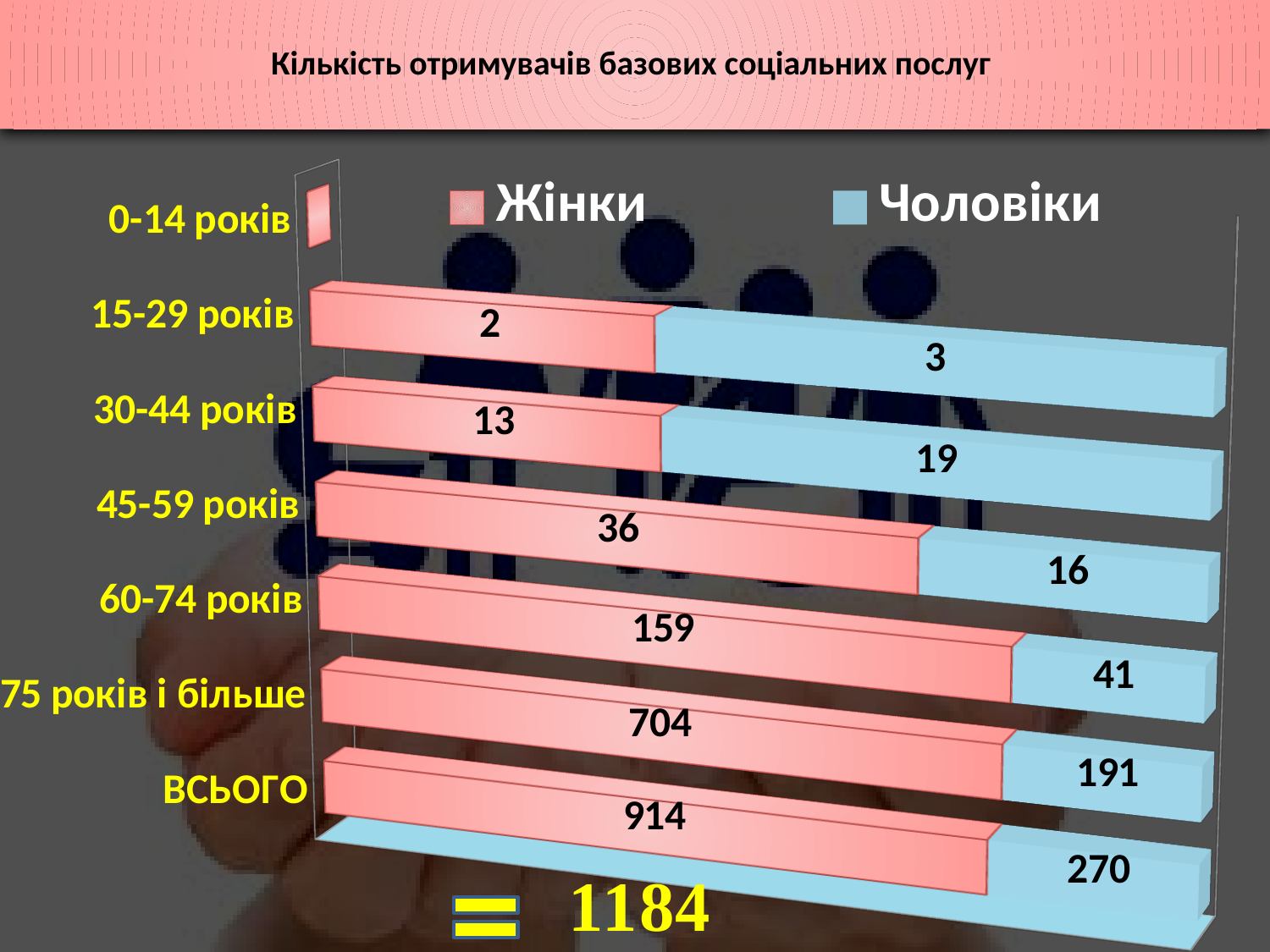
What kind of chart is shown on the slide? stacked bar chart How many series does the legend list? 2 What is the total of the stacked bar for the ВСЬОГО category? 1184 What is the total of the stacked bar for the 60-74 років category? 200 What is the title of the chart? Кількість отримувачів базових соціальних послуг What is the difference between the Жінки and Чоловіки values in the ВСЬОГО category? 644 What is the value for Чоловіки in the 60-74 років category? 41 What is the value for Жінки in the 45-59 років category? 36 Which age category has the highest value for Жінки (excluding ВСЬОГО)? 75 років і більше Which is larger in the 45-59 років category, Жінки or Чоловіки? Жінки What is the value for Жінки in the 75 років і більше category? 704 What is the value for Чоловіки in the 30-44 років category? 19